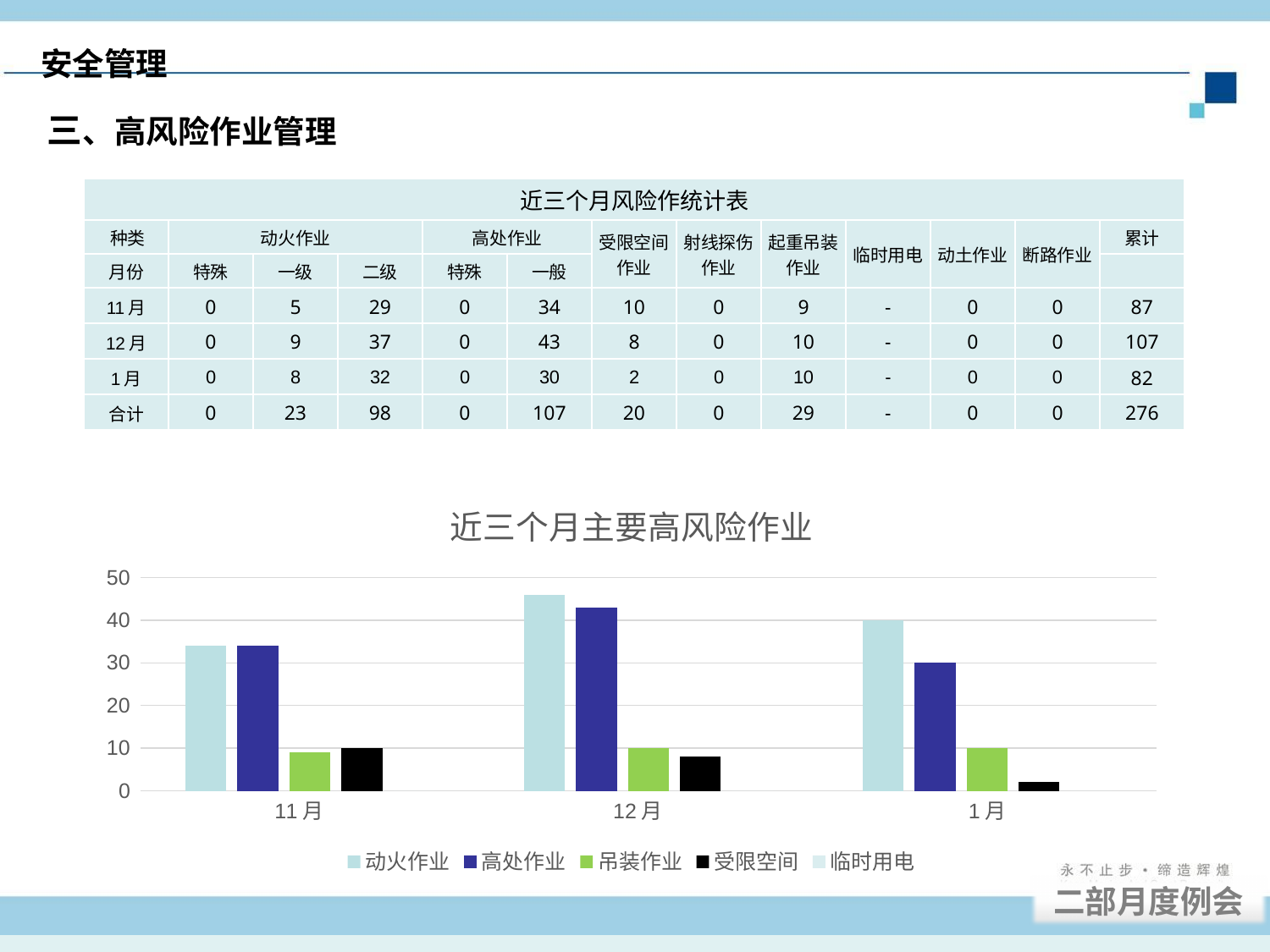
Does the value for 受限空间 rise or fall from 11月 to 1月? fall How many series does the chart legend list? 5 In which month is 动火作业 highest? 12月 Which series is listed last in the chart legend? 临时用电 Is the value for 动火作业 in 12月 greater or less than 40? greater Is the value for 受限空间 in 1月 greater or less than 10? less In 1月, which is larger: 动火作业 or 高处作业? 动火作业 Is the value for 高处作业 in 1月 greater or less than 40? less What kind of chart is shown on the slide? bar chart How many months are shown on the x axis of the chart? 3 What is the title of the chart? 近三个月主要高风险作业 In 1月, which is larger: 吊装作业 or 受限空间? 吊装作业